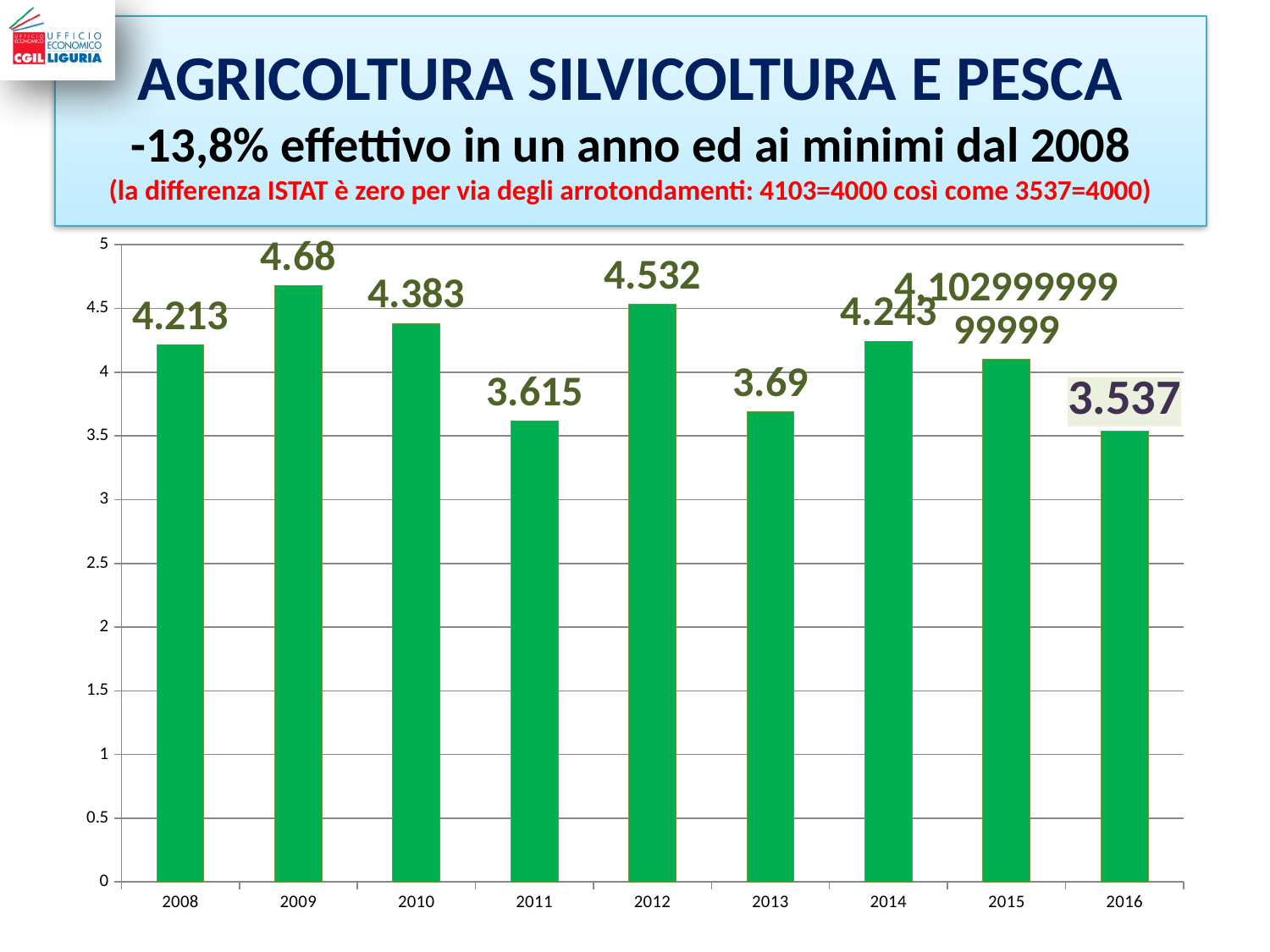
Which is larger, the value for 2010 or the value for 2013? 2010 What is the value for 2016? 3.537 Which year has the highest value? 2009 What is the value for 2011? 3.615 Which year has the lowest value? 2016 What is the difference between the values for 2009 and 2016? 1.143 Do the values rise or fall from 2014 to 2016? fall How many years are shown on the x axis? 9 What kind of chart is shown on the slide? bar chart What is the value for 2012? 4.532 Is the value for 2015 greater or less than 4? greater What is the value for 2009? 4.68